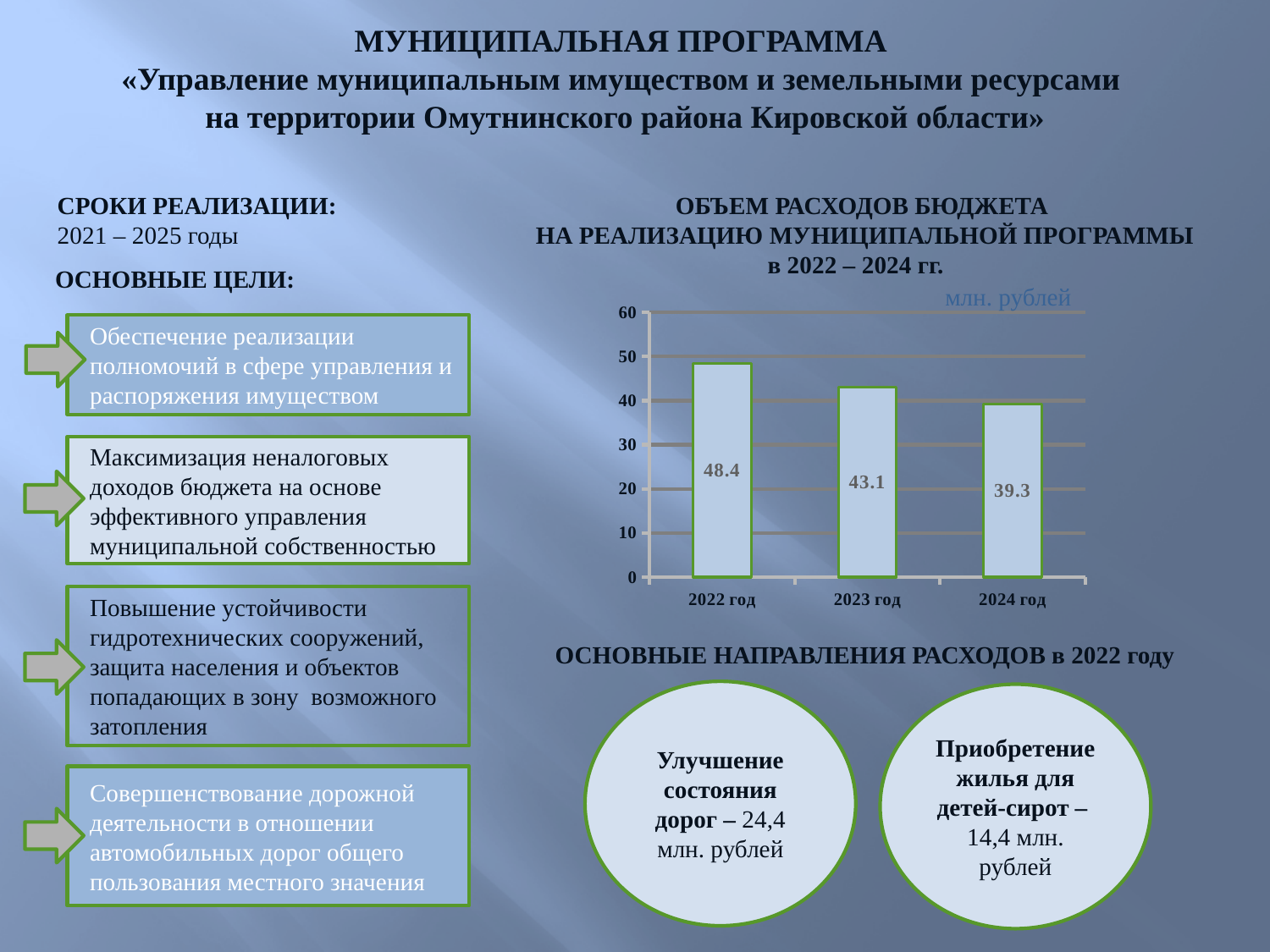
What is the budget expenditure value shown for 2024 год? 39.3 What is the difference between the values for 2022 год and 2024 год? 9.1 Which is larger, the value for 2023 год or the value for 2024 год? 2023 год What is the difference between the values for 2022 год and 2023 год? 5.3 Is the value for 2024 год greater or less than 40? less Which year has the lowest budget expenditure in the chart? 2024 год Do the values rise or fall from 2022 год to 2024 год? fall What is the budget expenditure value shown for 2023 год? 43.1 What is the budget expenditure value shown for 2022 год? 48.4 How many years (categories) are shown in the bar chart? 3 What type of chart is used to show the budget expenditure? bar chart Which year has the highest budget expenditure in the chart? 2022 год